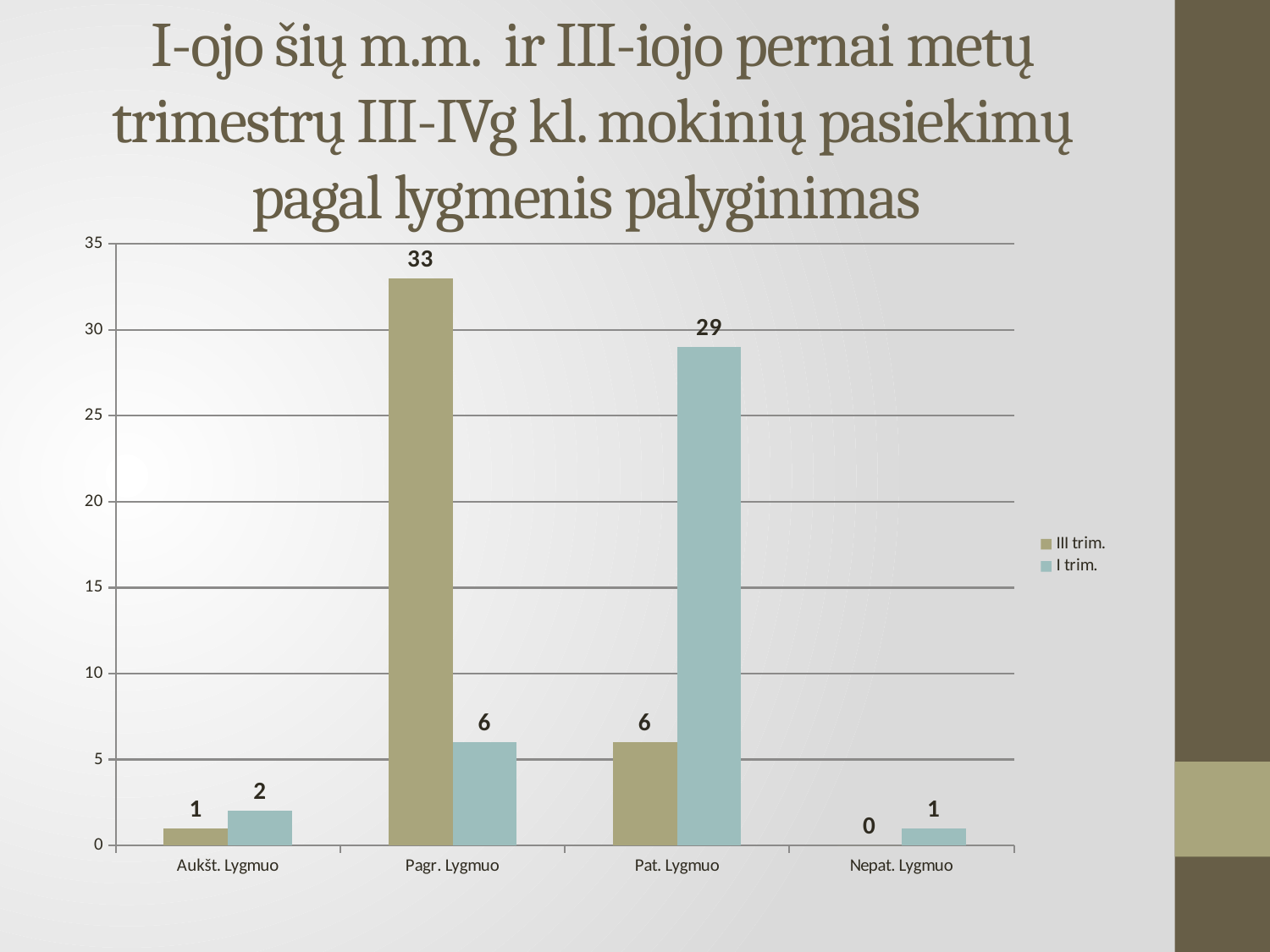
What is the value for I trim. in the Aukšt. Lygmuo category? 2 What are the two series names listed in the legend? III trim. and I trim. Which category has the highest value for the III trim. series? Pagr. Lygmuo In the Pat. Lygmuo category, which series has the larger value, III trim. or I trim.? I trim. What is the value for I trim. in the Pat. Lygmuo category? 29 Which category has the lowest value for the I trim. series? Nepat. Lygmuo How many series does the legend list? 2 What is the difference between the III trim. and I trim. values in the Pagr. Lygmuo category? 27 What is the value for III trim. in the Pagr. Lygmuo category? 33 What is the value for III trim. in the Nepat. Lygmuo category? 0 What kind of chart is shown on the slide? Bar chart How many categories are shown on the x axis? 4